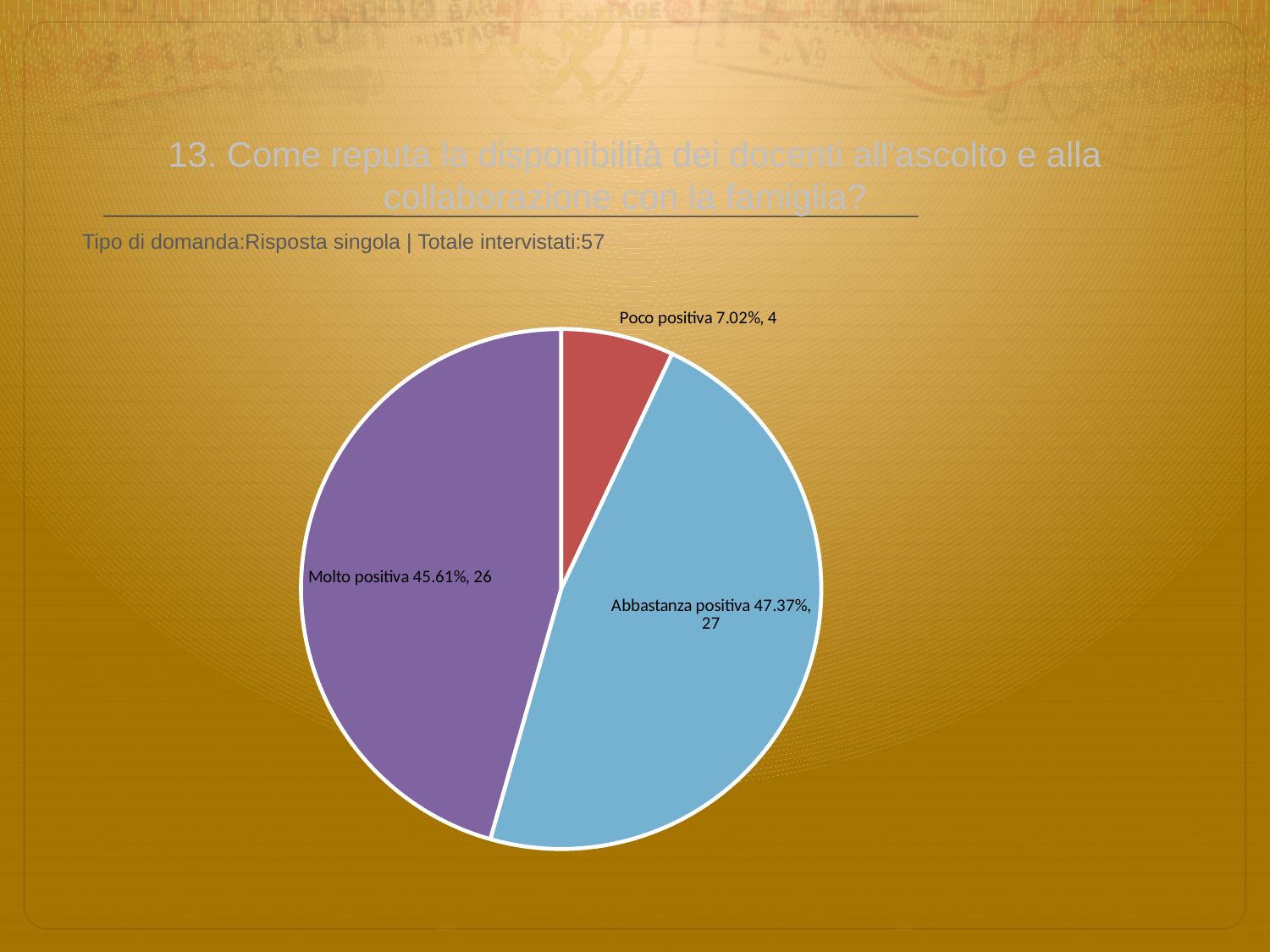
How many slices does the pie chart have? 3 How many respondents chose 'Poco positiva'? 4 What kind of chart is shown on the slide? pie chart What is the difference in respondent count between 'Abbastanza positiva' and 'Molto positiva'? 1 What colour is the 'Poco positiva' slice? red How many respondents chose 'Molto positiva'? 26 What percentage share does the 'Molto positiva' slice have? 45.61% What is the difference in respondent count between 'Molto positiva' and 'Poco positiva'? 22 What percentage share does the 'Poco positiva' slice have? 7.02% What percentage share does the 'Abbastanza positiva' slice have? 47.37% Which category has the smallest slice of the pie? Poco positiva How many respondents chose 'Abbastanza positiva'? 27